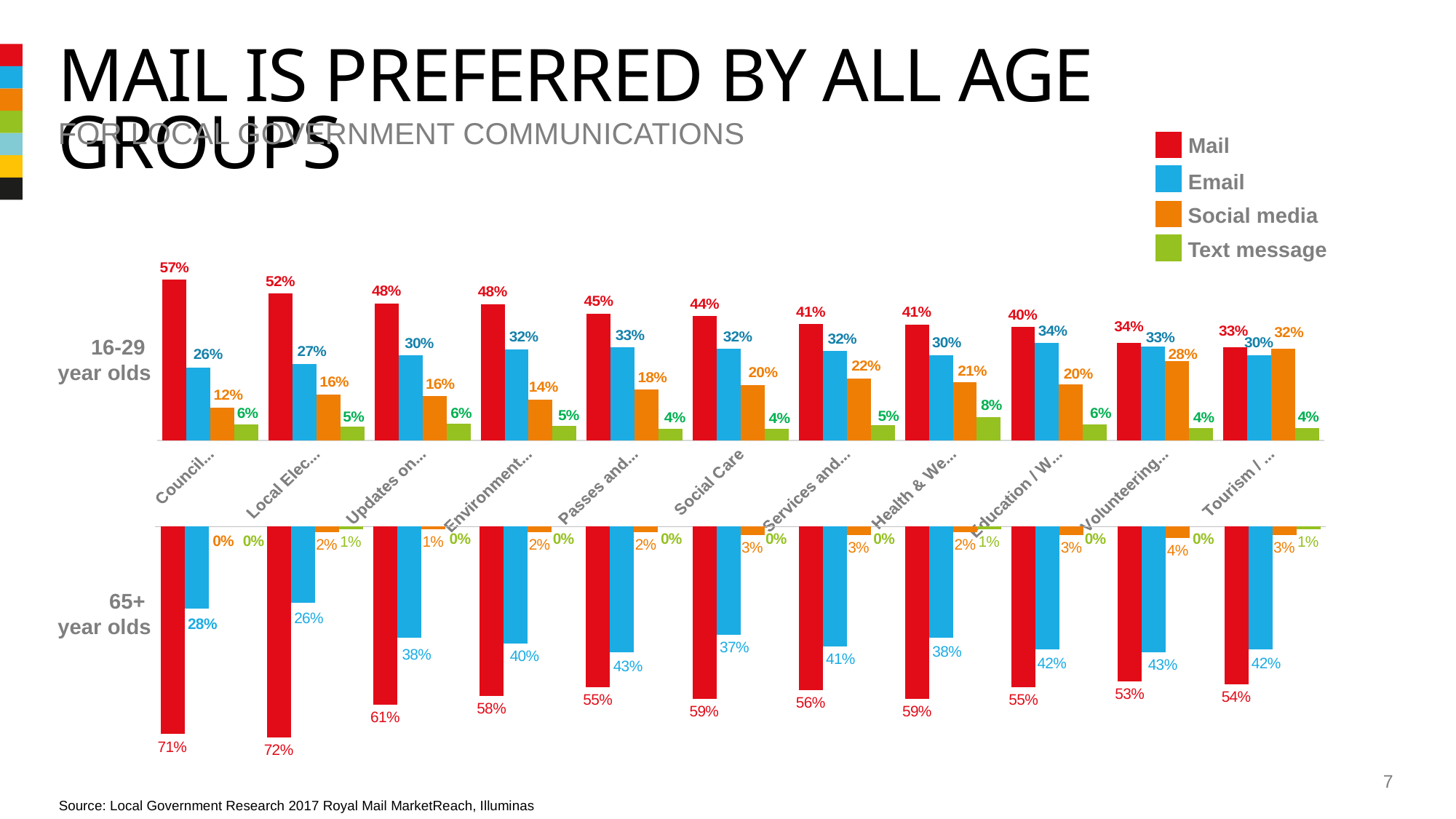
In the 16-29 year olds chart, what is the Mail value for Social Care? 44% In the 16-29 year olds chart, do the Mail values rise or fall from left to right across the categories? Fall In the 65+ year olds chart, what is the highest Mail value shown? 72% What colour represents Mail in the legend? Red In the 65+ year olds chart, what is the lowest Mail value shown? 53% How many categories are shown along the x axis of the 16-29 year olds chart? 11 What kind of chart is used on this slide? Bar chart In the 16-29 year olds chart, what is the difference between the Mail and Email values for Social Care? 12 percentage points How many series does the legend list? 4 In the 65+ year olds chart, which is larger for Social Care: Mail or Email? Mail In the 16-29 year olds chart, what is the highest Mail value shown? 57% In the 65+ year olds chart, what is the Email value for Social Care? 37%